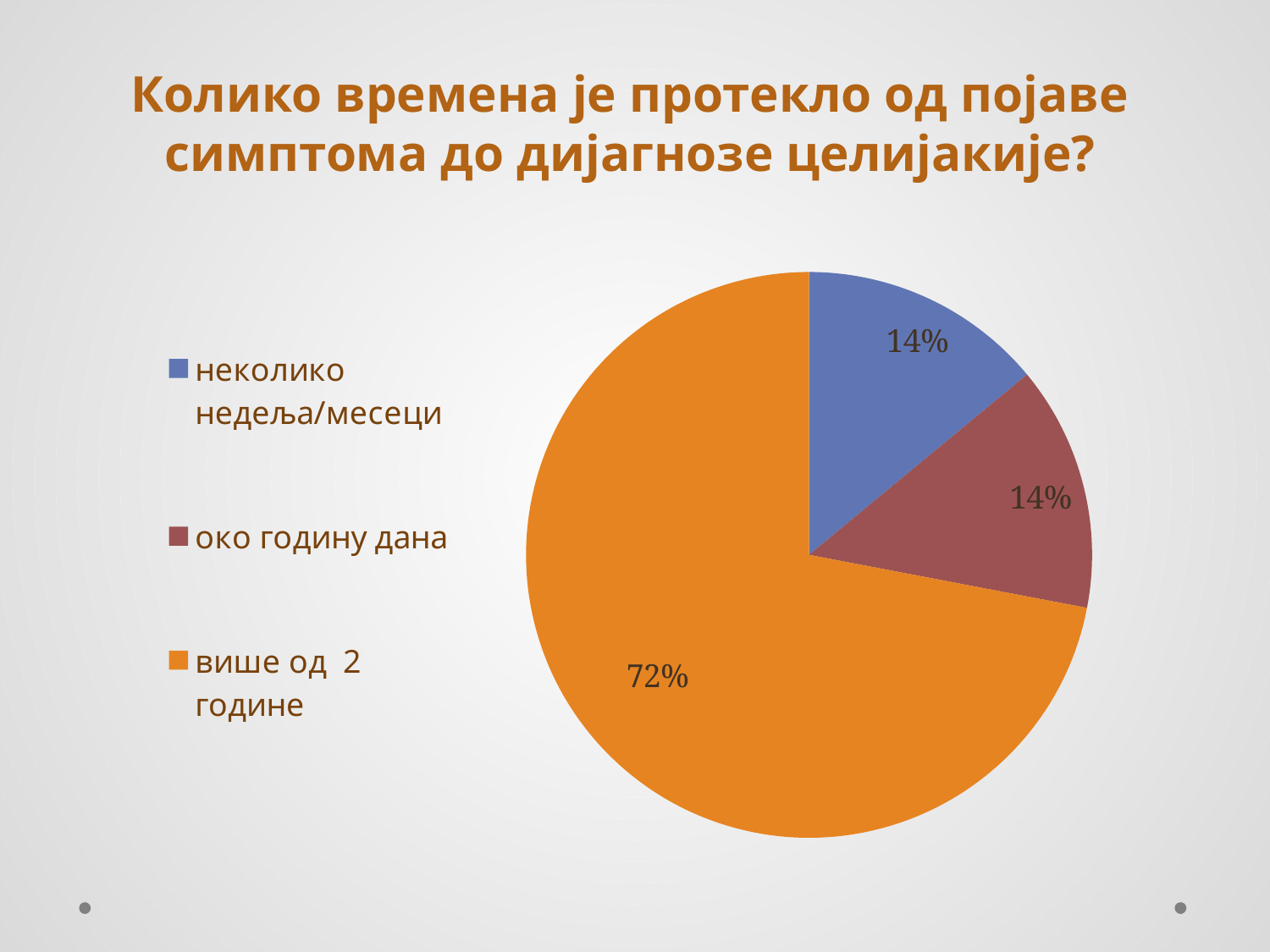
What is the title of the chart on the slide? Колико времена је протекло од појаве симптома до дијагнозе целијакије? What colour is the slice for "око годину дана"? dark red Which is larger, the slice for "више од 2 године" or the slice for "неколико недеља/месеци"? више од 2 године What is the difference in percentage points between "више од 2 године" and "око годину дана"? 58 Which category has the largest slice of the pie? више од 2 године What kind of chart is shown on the slide? pie chart What share of the pie does "више од 2 године" take? 72% How many slices does the pie chart have? 3 What share of the pie does "око годину дана" take? 14% How many entries does the legend list? 3 What share of the pie does "неколико недеља/месеци" take? 14% What is the combined share of "неколико недеља/месеци" and "око годину дана"? 28%